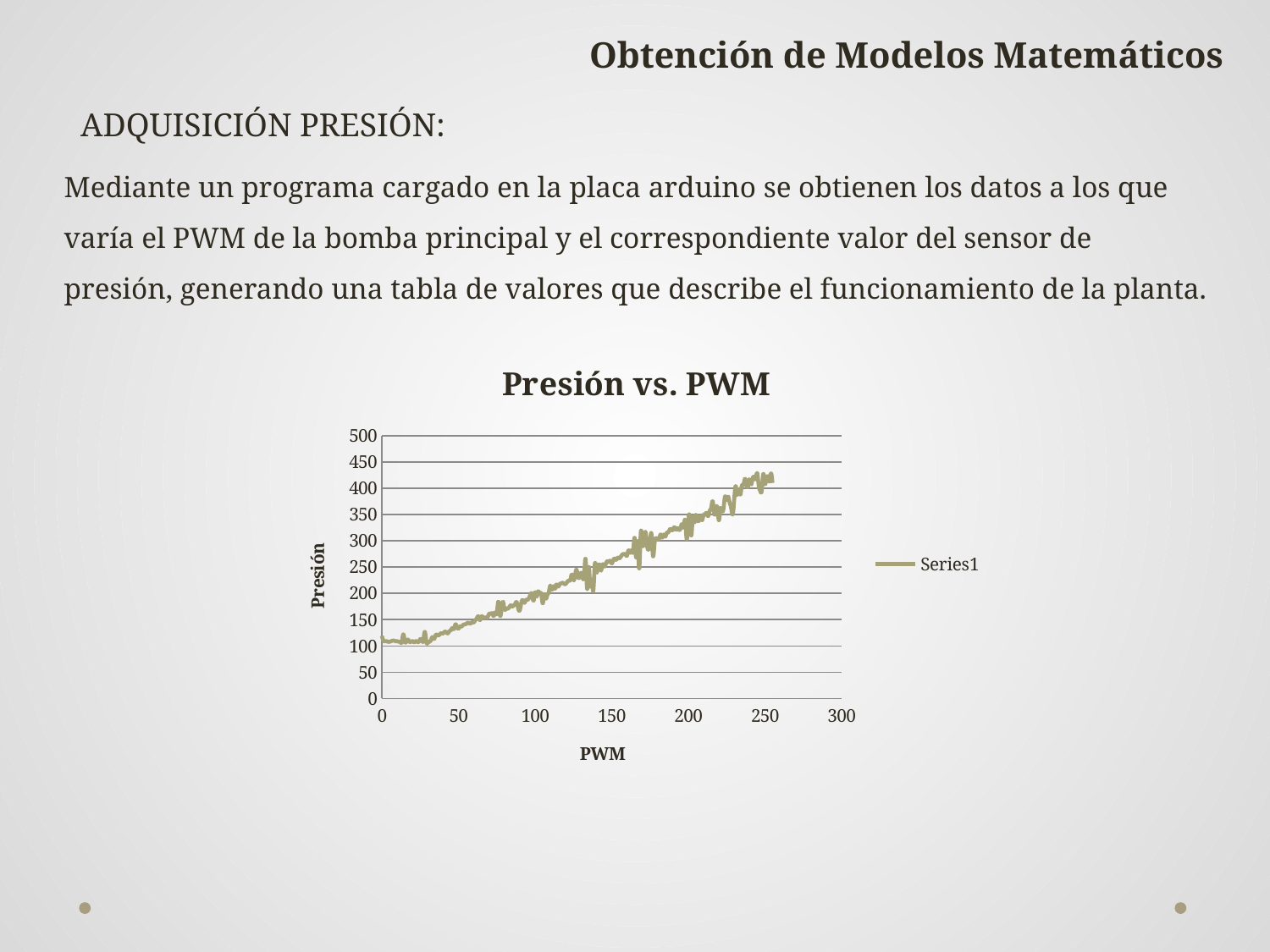
Is the Presión value at PWM 0 greater or less than 200? less What is the name of the series shown in the legend? Series1 Is the Presión value at PWM 150 greater or less than 150? greater What kind of chart is shown on the slide? line chart Is the Presión value at PWM 200 greater or less than 300? greater What is the title of the chart? Presión vs. PWM How many series does the legend list? 1 Does the Presión value generally rise or fall as PWM increases along the x axis? rise